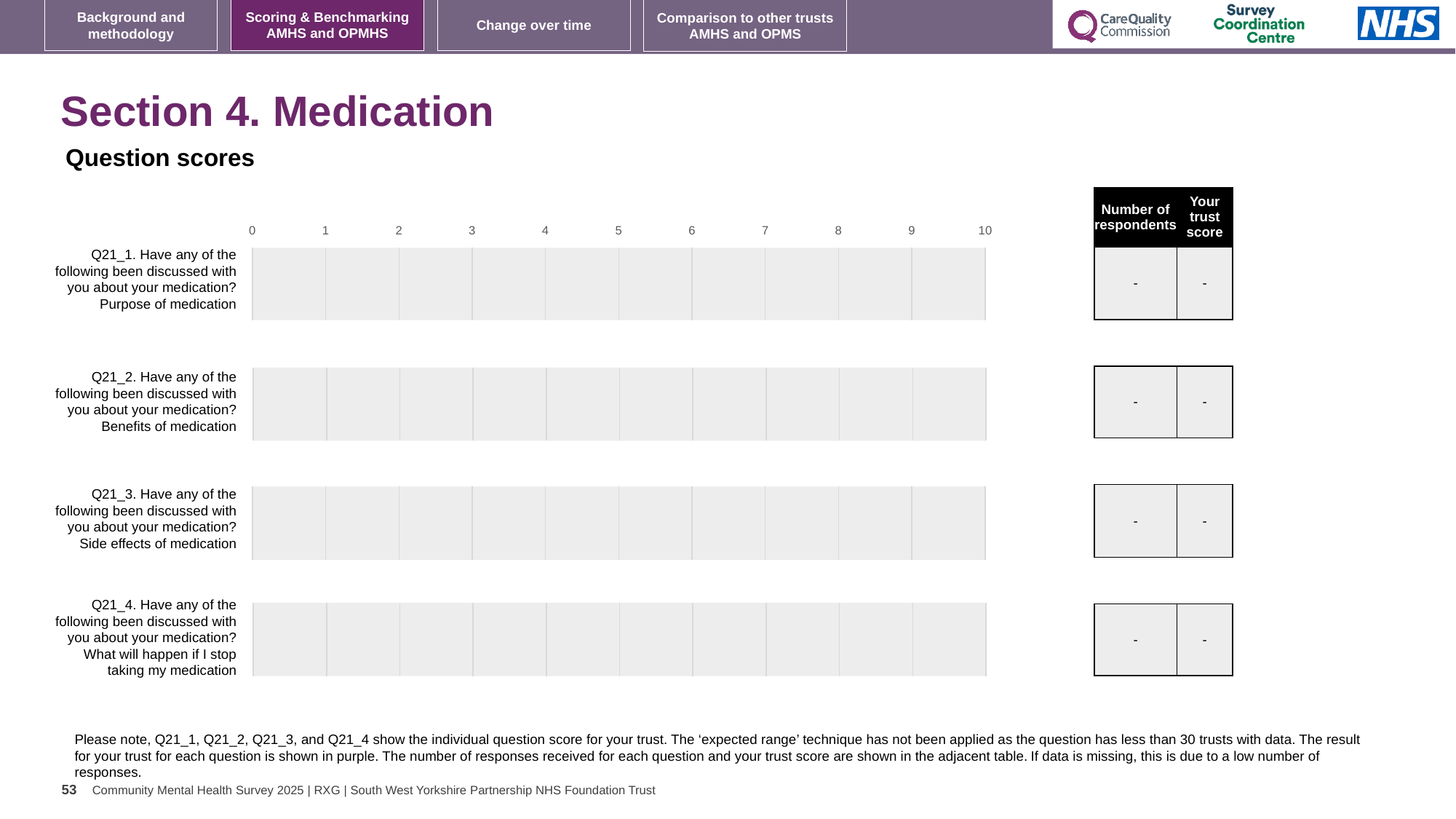
What is shown in the 'Number of respondents' column for Q21_3 (Side effects of medication)? - What kind of chart is used for the question scores on this slide? bar chart What is the highest value shown on the x axis of the question score charts? 10 What is shown in the 'Your trust score' column for Q21_2 (Benefits of medication)? - How many questions (Q21_1 to Q21_4) have a chart row on this slide? 4 Is a trust score bar plotted for Q21_4 (What will happen if I stop taking my medication)? no Is a trust score bar plotted for Q21_1 (Purpose of medication)? no What is the lowest value shown on the x axis of the question score charts? 0 What is the section title of this slide? Section 4. Medication